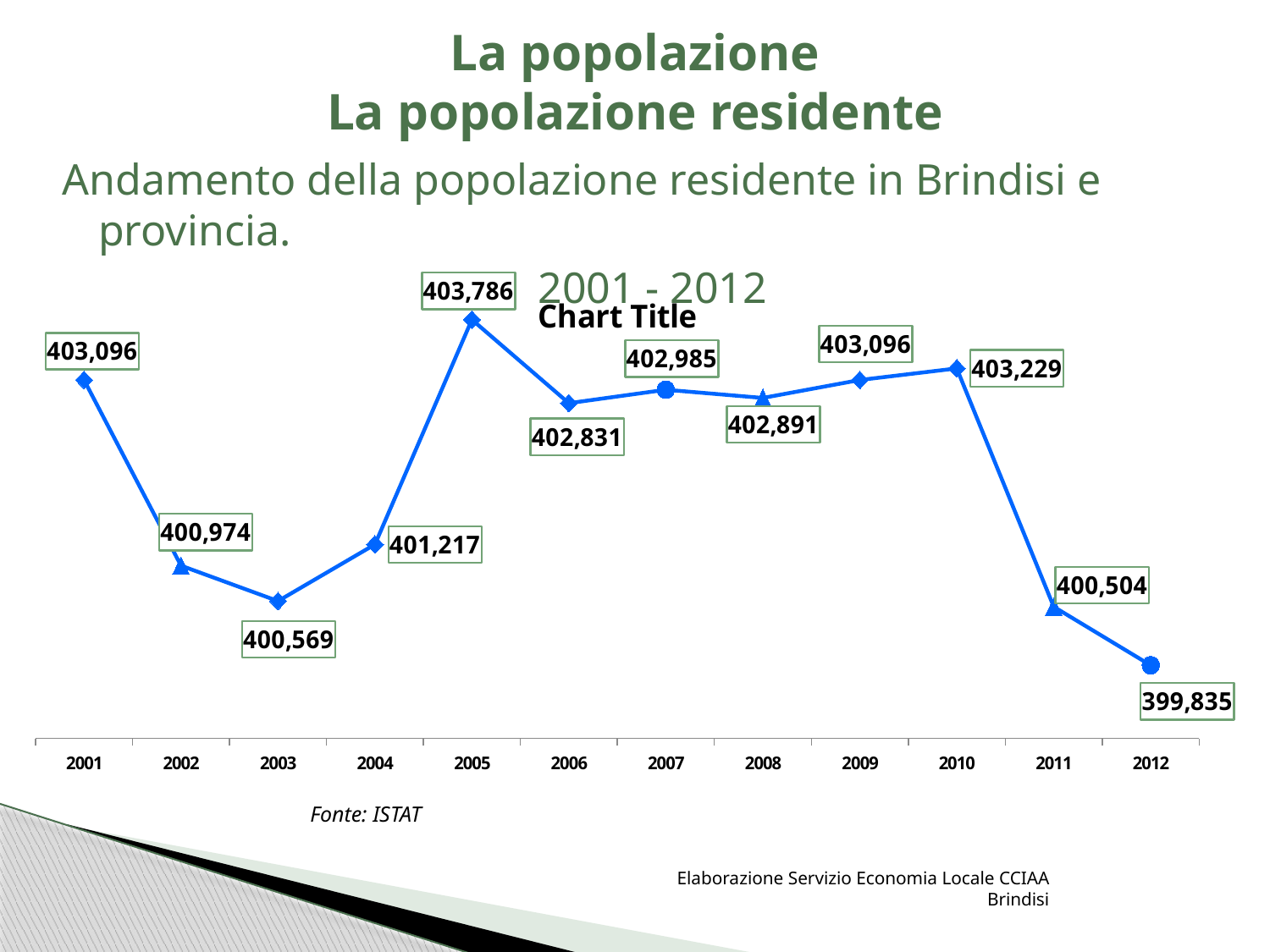
Which year has the lowest value on the chart? 2012 Do the values rise or fall from 2010 to 2012? Fall Which year has the highest value on the chart? 2005 What is the difference between the values for 2005 and 2012? 3,951 What is the resident population value shown for 2005? 403,786 What is the value shown for 2003? 400,569 What is the value shown for 2012? 399,835 What is the value shown for 2008? 402,891 Which is larger, the value for 2007 or the value for 2006? 2007 How many years (data points) are plotted on the chart? 12 What is the difference between the values for 2010 and 2011? 2,725 What kind of chart is shown on the slide? Line chart